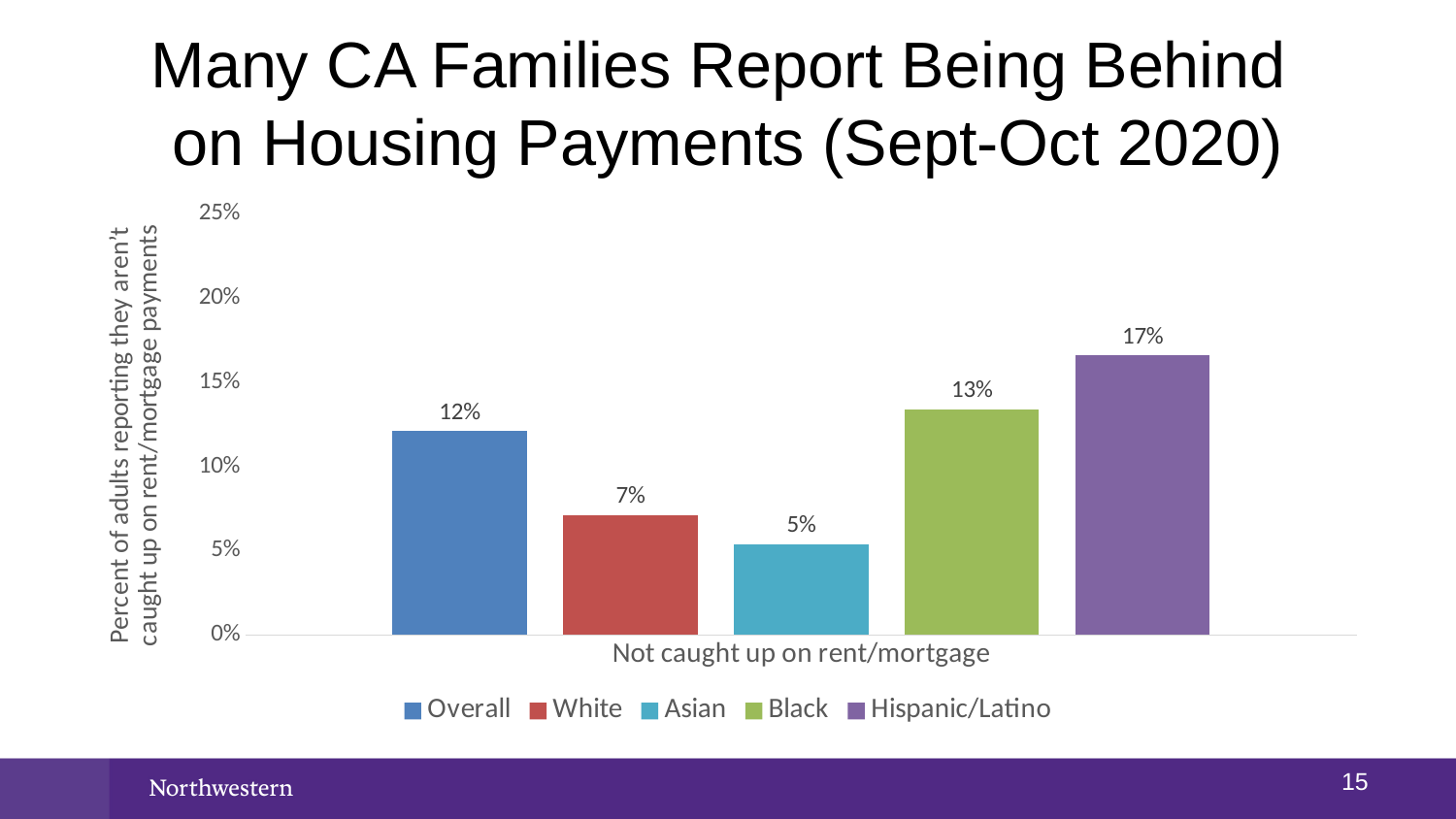
Which group has the lowest percent not caught up on rent/mortgage? Asian What is the difference between the Black and White values? 6% Which group has the highest percent not caught up on rent/mortgage? Hispanic/Latino What kind of chart is shown on the slide? bar chart Is the value for Hispanic/Latino greater or less than 15%? greater Which is larger, the value for White or the value for Black? Black How many series does the legend list? 5 What is the value for Asian adults? 5% What percent of Hispanic/Latino adults report not being caught up on rent/mortgage? 17% What colour is the bar for Hispanic/Latino? purple What is the label on the vertical axis? Percent of adults reporting they aren't caught up on rent/mortgage payments What is the value for the Overall series? 12%